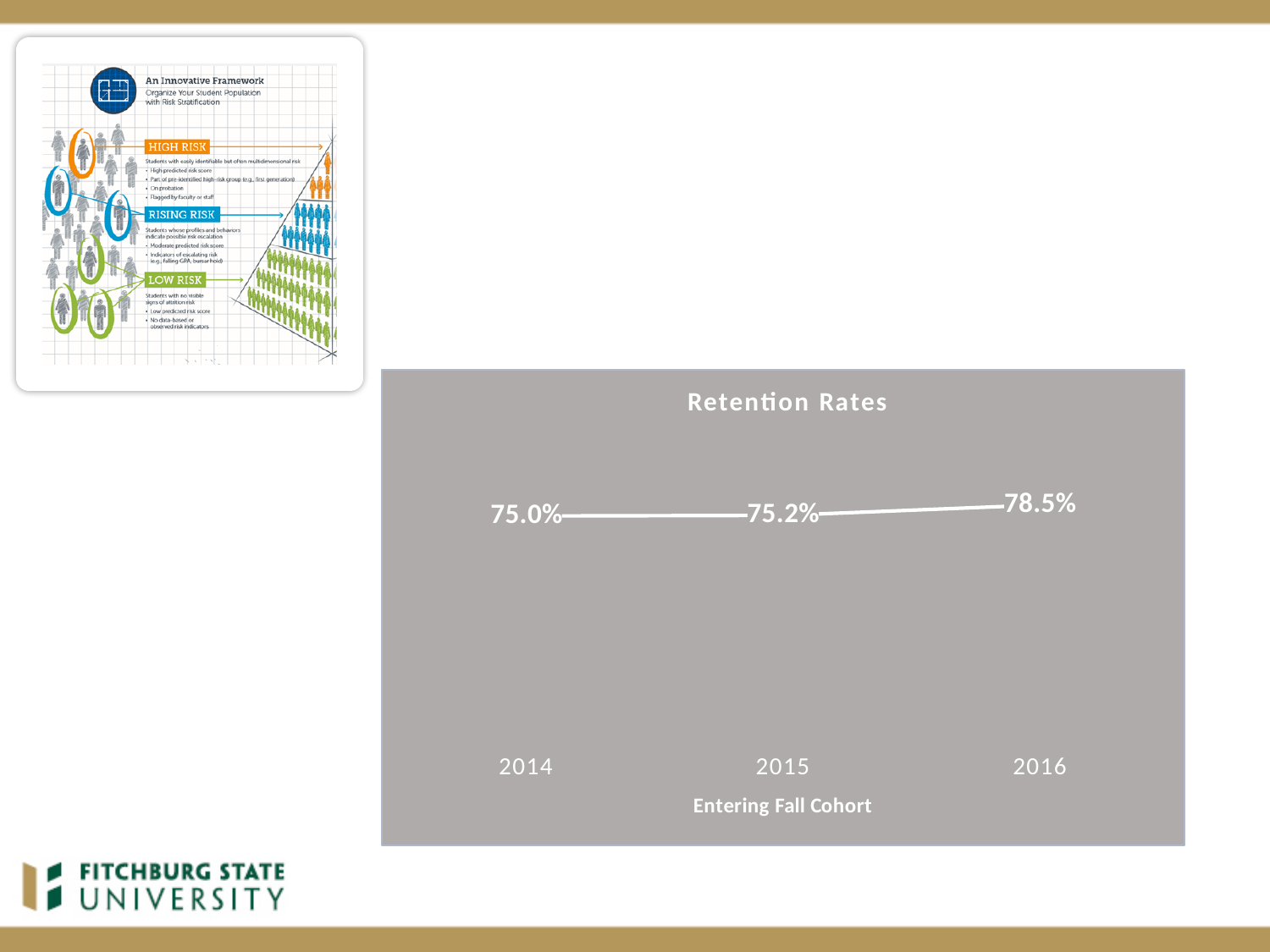
What is the difference in retention rate between the 2015 and 2014 cohorts? 0.2% What kind of chart is the Retention Rates chart? line chart What is the difference in retention rate between the 2016 and 2014 cohorts? 3.5% What is the retention rate for the 2016 entering fall cohort? 78.5% What is the retention rate for the 2014 entering fall cohort? 75.0% Do retention rates rise or fall from 2014 to 2016? rise What is the retention rate for the 2015 entering fall cohort? 75.2% Which cohort has a higher retention rate, 2015 or 2016? 2016 Which entering fall cohort has the highest retention rate? 2016 What is the x-axis title of the Retention Rates chart? Entering Fall Cohort Which entering fall cohort has the lowest retention rate? 2014 How many entering fall cohorts are plotted in the Retention Rates chart? 3